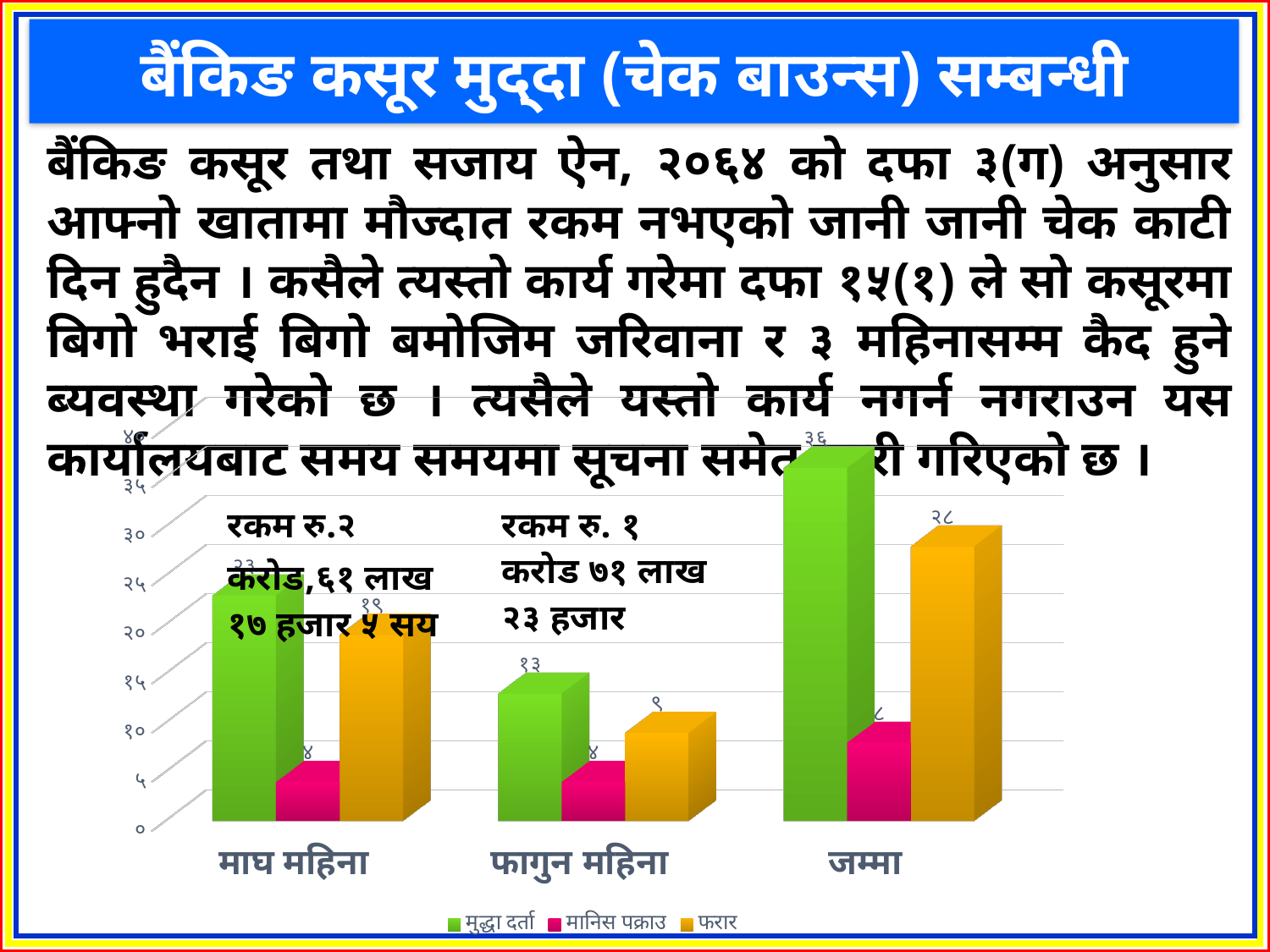
What is the value of फरार for जम्मा? २८ What is the value of मुद्धा दर्ता for फागुन महिना? १३ How many series does the chart legend list? 3 Which category has the highest मुद्धा दर्ता value? जम्मा What is the value of मुद्धा दर्ता for जम्मा? ३६ What is the value of मानिस पक्राउ for माघ महिना? ४ Is the मुद्धा दर्ता value for माघ महिना greater or less than २०? greater What is the difference between the फरार values for माघ महिना and फागुन महिना? १० What is the value of फरार for फागुन महिना? ९ What type of chart is shown on the slide? bar chart What is the value of फरार for माघ महिना? १९ How many categories are shown on the x axis of the chart? 3